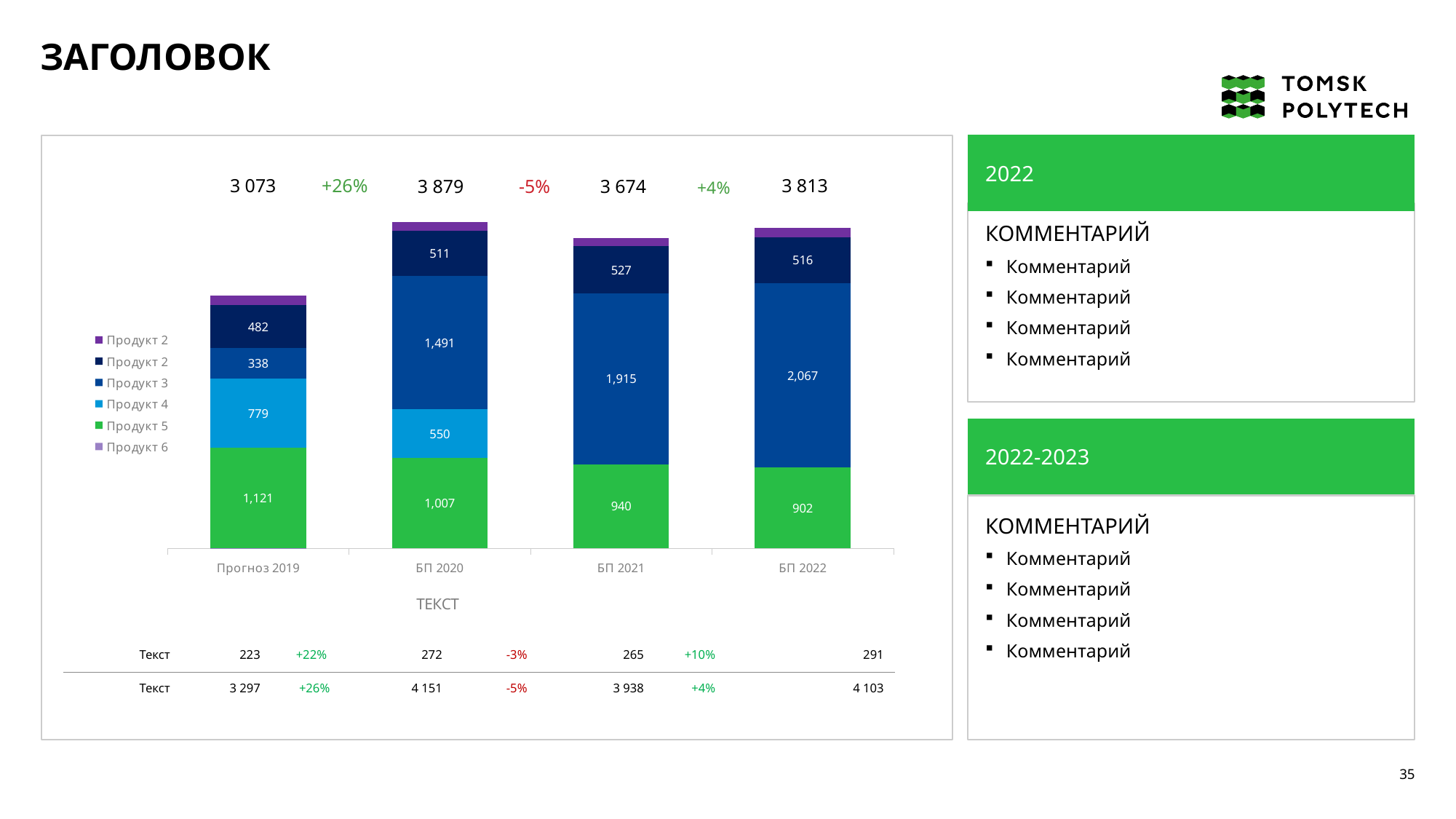
What is the value of Продукт 3 for БП 2022? 2,067 What is the value of Продукт 4 for БП 2020? 550 What is the difference between Продукт 3 for БП 2022 and Продукт 3 for БП 2021? 152 Which category has the highest total value? БП 2020 What is the value of Продукт 5 for Прогноз 2019? 1,121 What kind of chart is shown on the slide? Stacked bar chart Which is larger: Продукт 5 for Прогноз 2019 or Продукт 5 for БП 2022? Прогноз 2019 How many series does the legend list? 6 What is the total shown above the bar for БП 2020? 3 879 How many categories are shown on the x axis? 4 Does the value of Продукт 5 rise or fall from Прогноз 2019 to БП 2022? Fall Which category has the lowest total value? Прогноз 2019